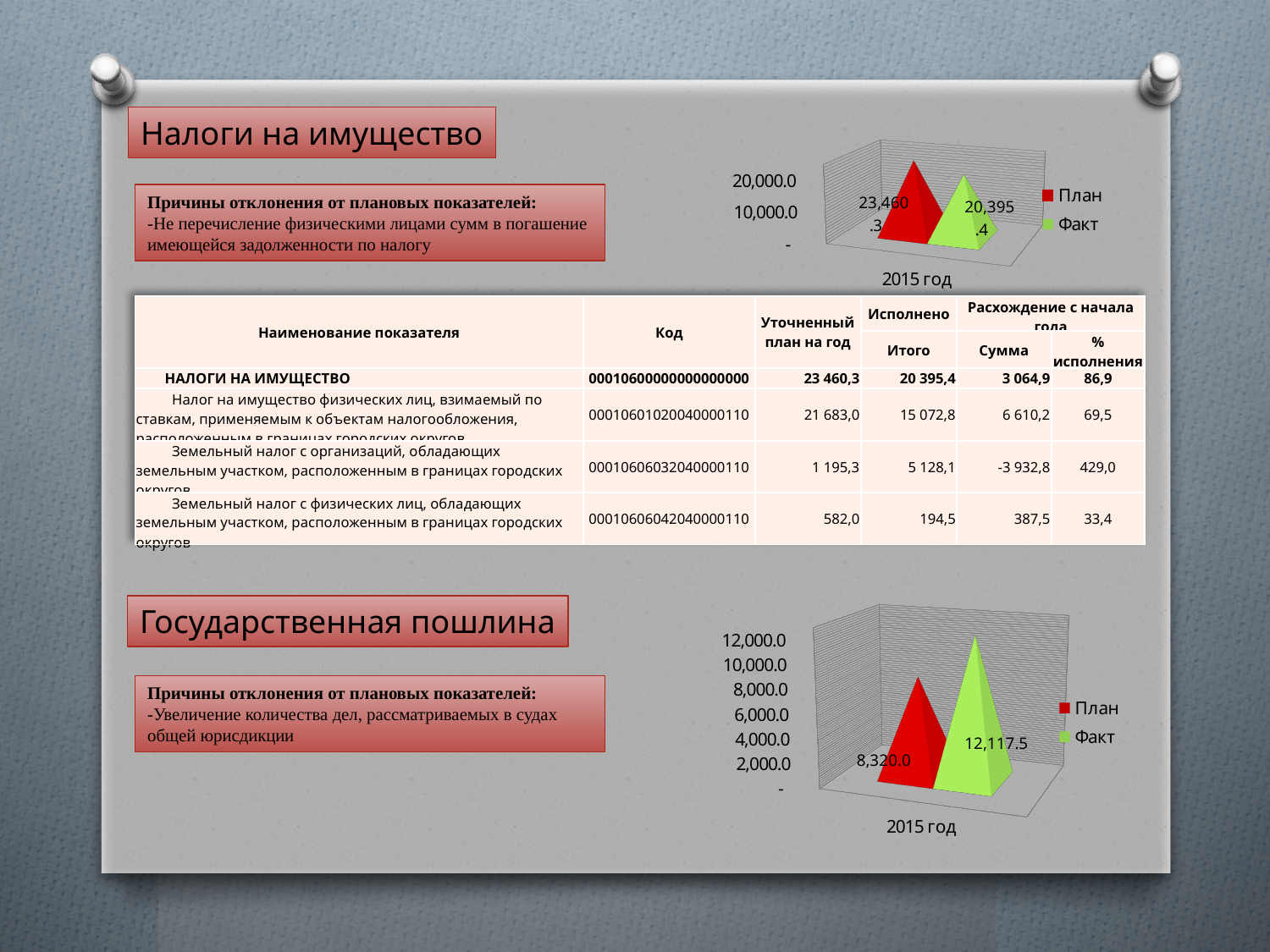
In the bottom chart (Государственная пошлина), what is the value for Факт in 2015 год? 12,117.5 In the bottom chart (Государственная пошлина), which series has the higher value, План or Факт? Факт In the top chart (Налоги на имущество), what is the difference between План and Факт? 3,064.9 In the top chart (Налоги на имущество), is the value for Факт greater or less than 10,000.0? greater In the bottom chart (Государственная пошлина), what is the difference between Факт and План? 3,797.5 In the top chart (Налоги на имущество), what is the value for Факт in 2015 год? 20,395.4 In the bottom chart (Государственная пошлина), is the value for План greater or less than 10,000.0? less What kind of chart is the bottom chart (Государственная пошлина)? bar chart In the top chart (Налоги на имущество), what is the value for План in 2015 год? 23,460.3 In the bottom chart (Государственная пошлина), what is the value for План in 2015 год? 8,320.0 In the top chart (Налоги на имущество), which series has the higher value, План or Факт? План In the top chart (Налоги на имущество), how many series does the legend list? 2